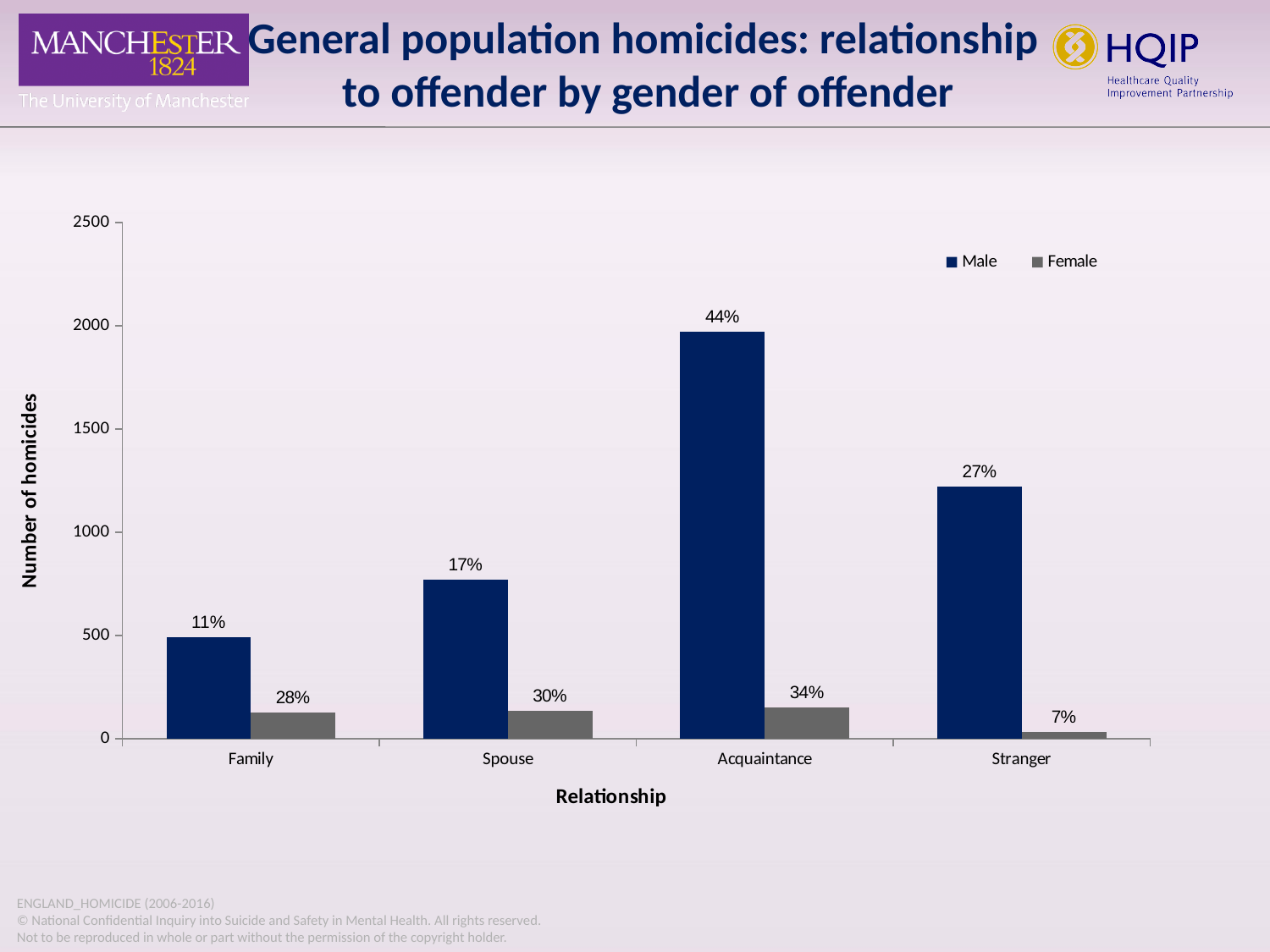
How many series does the legend list? 2 Which is taller, the Male bar for Acquaintance or the Male bar for Stranger? Acquaintance What is the title of the y axis? Number of homicides How many relationship categories are shown on the x axis? 4 What percentage label is shown on the Male bar for Family? 11% Which relationship category has the shortest Female bar? Stranger Which relationship category has the tallest Male bar? Acquaintance What percentage label is shown on the Female bar for Stranger? 7% What percentage label is shown on the Female bar for Spouse? 30% Is the Male bar for Acquaintance greater or less than 1500 homicides? greater Is the Male bar for Spouse greater or less than 1000 homicides? less What percentage label is shown on the Male bar for Acquaintance? 44%